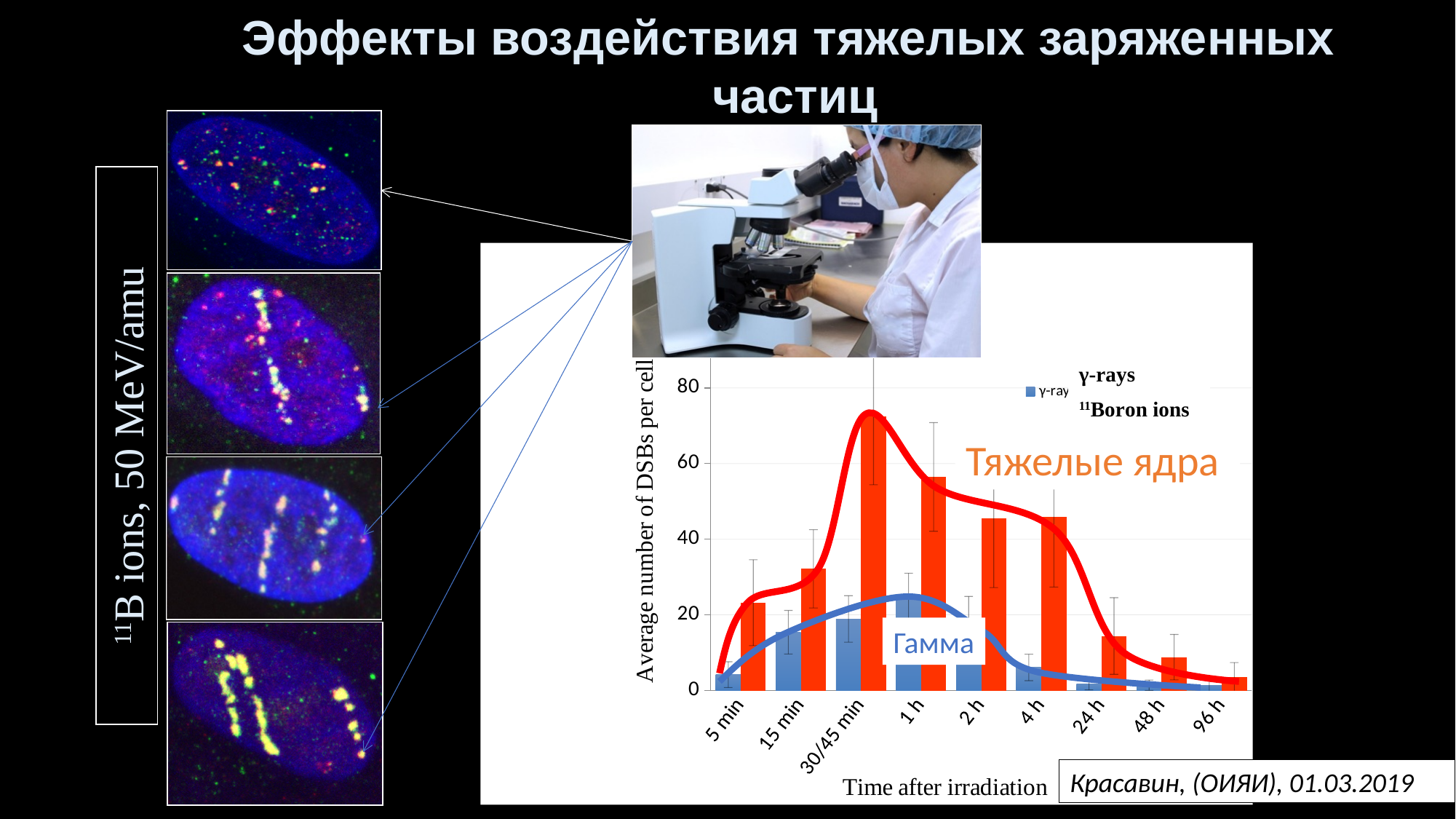
Is the value for 11Boron ions at 30/45 min greater or less than 60? greater Is the value for γ-rays at 1 h greater or less than 20? greater At which time point is the value for γ-rays highest? 1 h What kind of chart is shown on the slide? bar chart How many time points are shown on the x axis of the chart? 9 At which time point is the value for 11Boron ions lowest? 96 h Is the value for 11Boron ions at 24 h greater or less than 20? less What is the label of the y axis of the chart? Average number of DSBs per cell Which series has the larger value at 30/45 min, γ-rays or 11Boron ions? 11Boron ions At which time point is the value for 11Boron ions highest? 30/45 min Which is larger for 11Boron ions, the value at 15 min or the value at 1 h? 1 h How many data series does the chart show? 2